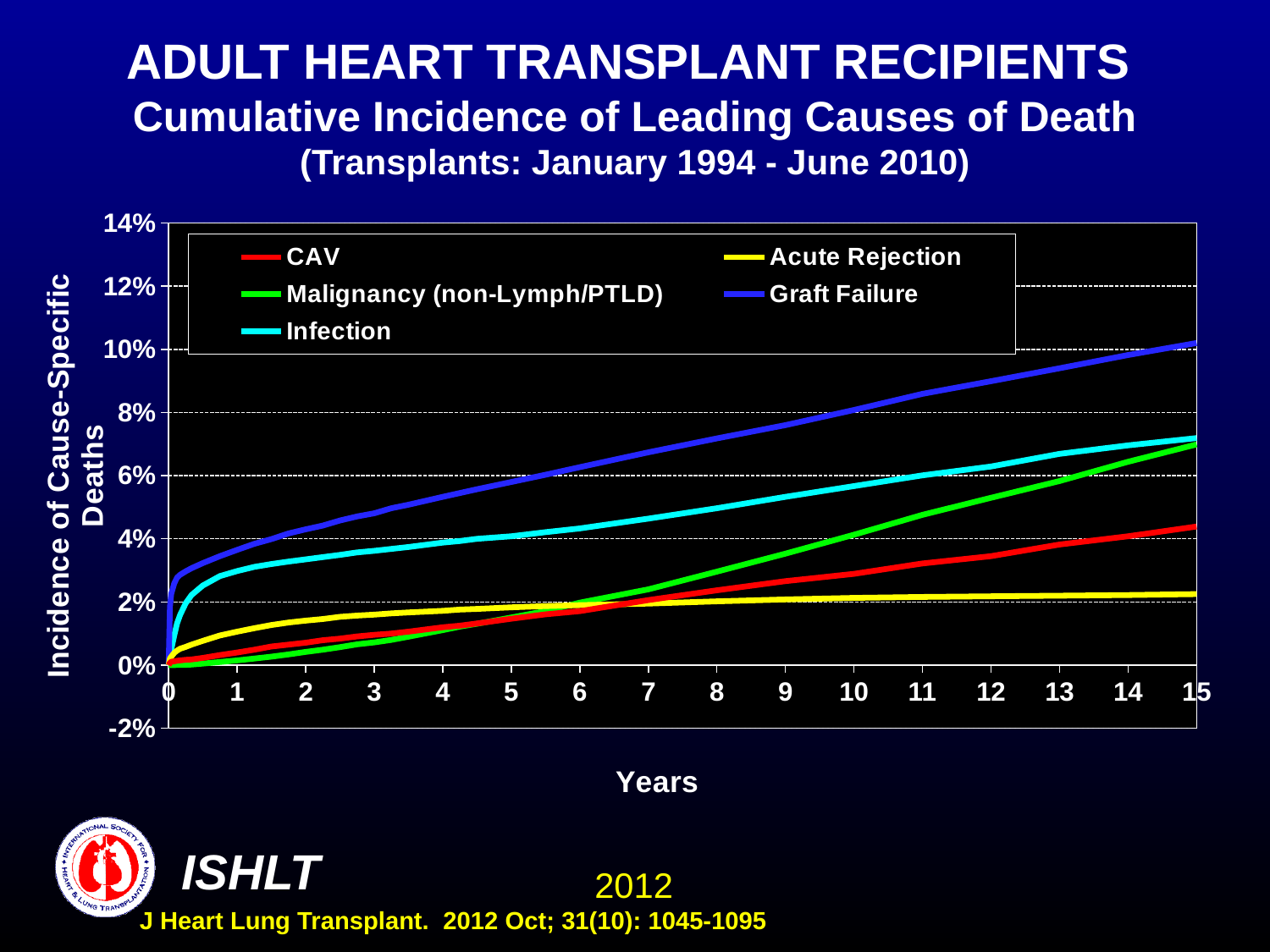
How many series does the legend list? 5 Does the cumulative incidence for Graft Failure rise or fall as years increase? rise At 15 years, which is larger: the cumulative incidence for Malignancy (non-Lymph/PTLD) or for CAV? Malignancy (non-Lymph/PTLD) Is the cumulative incidence for Infection at 15 years greater or less than 6%? greater What kind of chart is shown on the slide? line chart Which cause of death has the lowest cumulative incidence at 15 years? Acute Rejection At 10 years, which is larger: the cumulative incidence for Graft Failure or for Infection? Graft Failure Is the cumulative incidence for Graft Failure at 15 years greater or less than 8%? greater Is the cumulative incidence for CAV at 15 years greater or less than 6%? less Which cause of death has the highest cumulative incidence at 15 years? Graft Failure What is the label of the x axis? Years